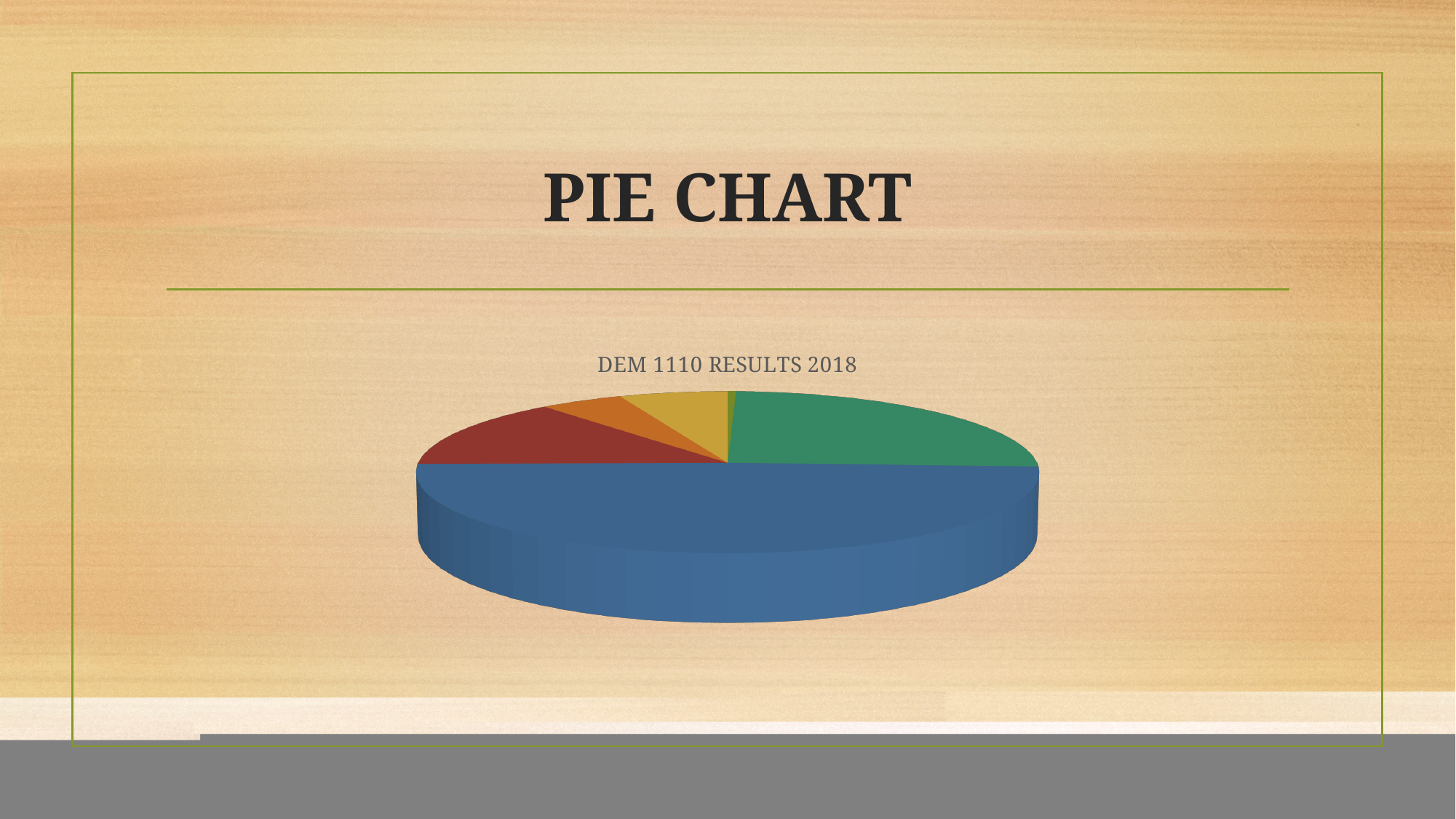
Does the chart display a legend? No Which is larger, the blue slice or the green slice? Blue Which is larger, the red slice or the orange slice? Red What kind of chart is shown on the slide? Pie chart Which colour slice is the largest in the pie chart? Blue Which is larger, the green slice or the red slice? Green What is the title of the chart? DEM 1110 RESULTS 2018